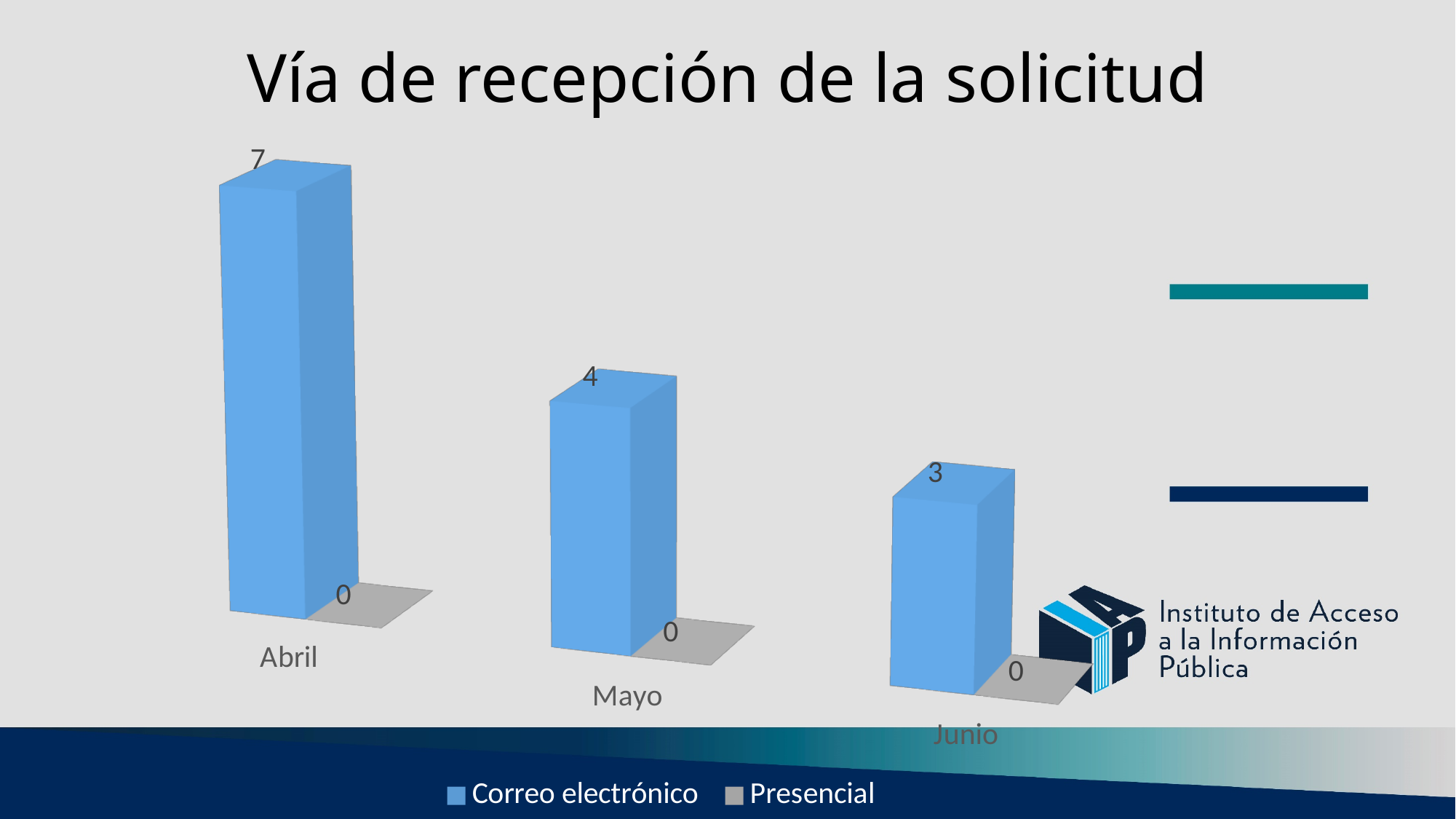
Do the Correo electrónico values rise or fall from Abril to Junio? Fall Which is larger, the Correo electrónico value for Mayo or for Junio? Mayo How many series does the legend list? 2 Which month has the highest value for Correo electrónico? Abril What is the value for Correo electrónico in Junio? 3 What is the value for Correo electrónico in Abril? 7 What is the value for Correo electrónico in Mayo? 4 Which month has the lowest value for Correo electrónico? Junio What kind of chart is shown on the slide? Bar chart What is the difference between the Correo electrónico values for Abril and Mayo? 3 How many months are shown on the x axis? 3 What is the value for Presencial in Abril? 0